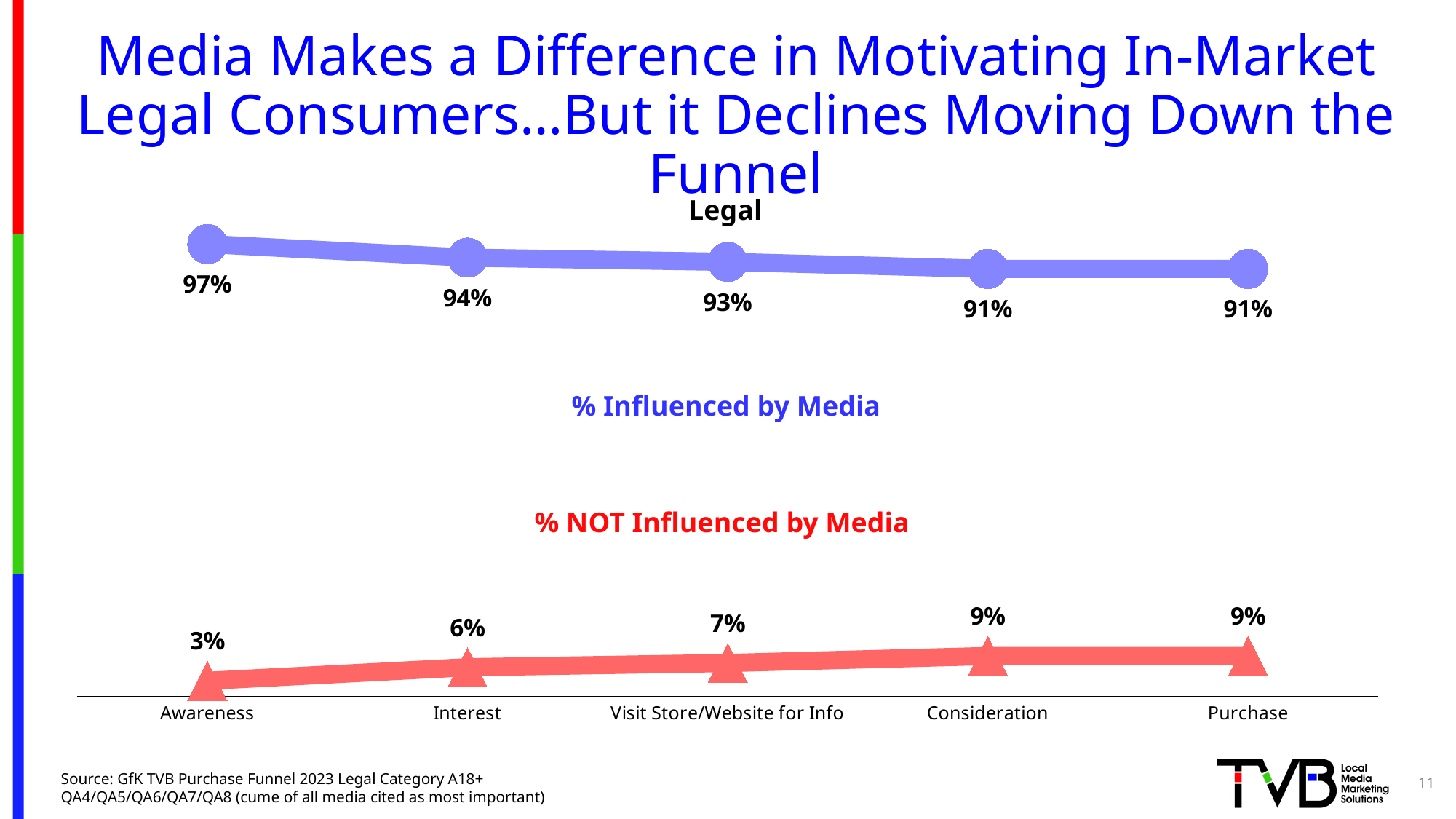
What is the % NOT Influenced by Media value for Awareness? 3% Which funnel stage has the highest % Influenced by Media value? Awareness How many funnel stages are shown on the x axis? 5 What is the % Influenced by Media value for Awareness? 97% What is the difference between the % Influenced by Media values for Awareness and Purchase? 6% What is the % Influenced by Media value for Visit Store/Website for Info? 93% Which is larger, the % Influenced by Media value for Interest or for Consideration? Interest Which funnel stage has the lowest % NOT Influenced by Media value? Awareness What is the difference between the % NOT Influenced by Media values for Interest and Purchase? 3% What is the % NOT Influenced by Media value for Consideration? 9% Does the % Influenced by Media line rise or fall moving from Awareness to Purchase? Fall What is the title of the chart? Legal